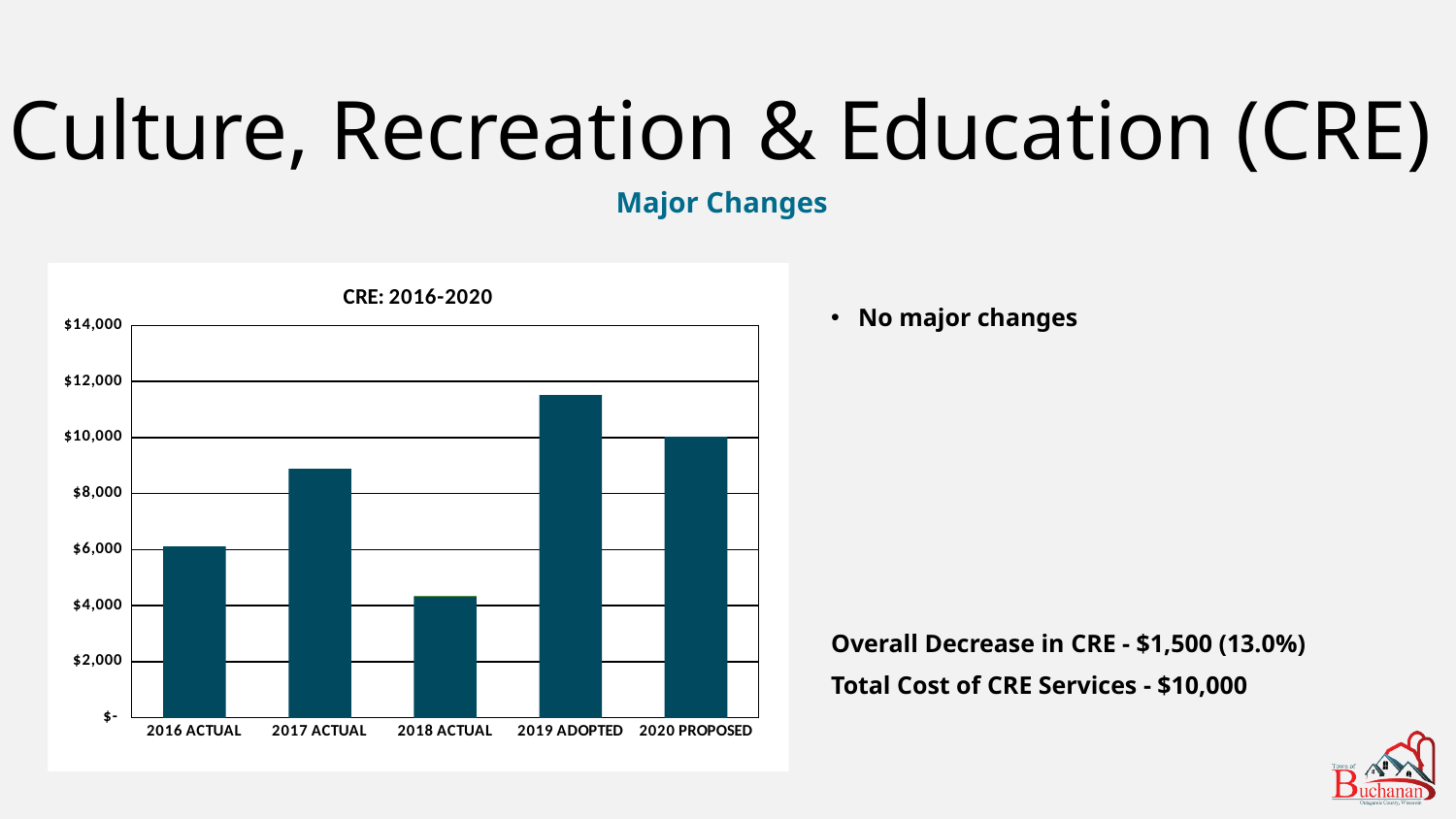
Which category has the lowest value in the chart? 2018 ACTUAL What kind of chart is shown on the slide? bar chart Is the value for 2016 ACTUAL greater or less than $8,000? less How many categories are shown on the x axis of the chart? 5 What is the title of the chart? CRE: 2016-2020 Which is larger, the value for 2017 ACTUAL or the value for 2016 ACTUAL? 2017 ACTUAL Is the value for 2017 ACTUAL greater or less than $8,000? greater Which category has the highest value in the chart? 2019 ADOPTED Is the value for 2019 ADOPTED greater or less than $10,000? greater What is the value for 2020 PROPOSED? $10,000 Which is larger, the value for 2019 ADOPTED or the value for 2020 PROPOSED? 2019 ADOPTED